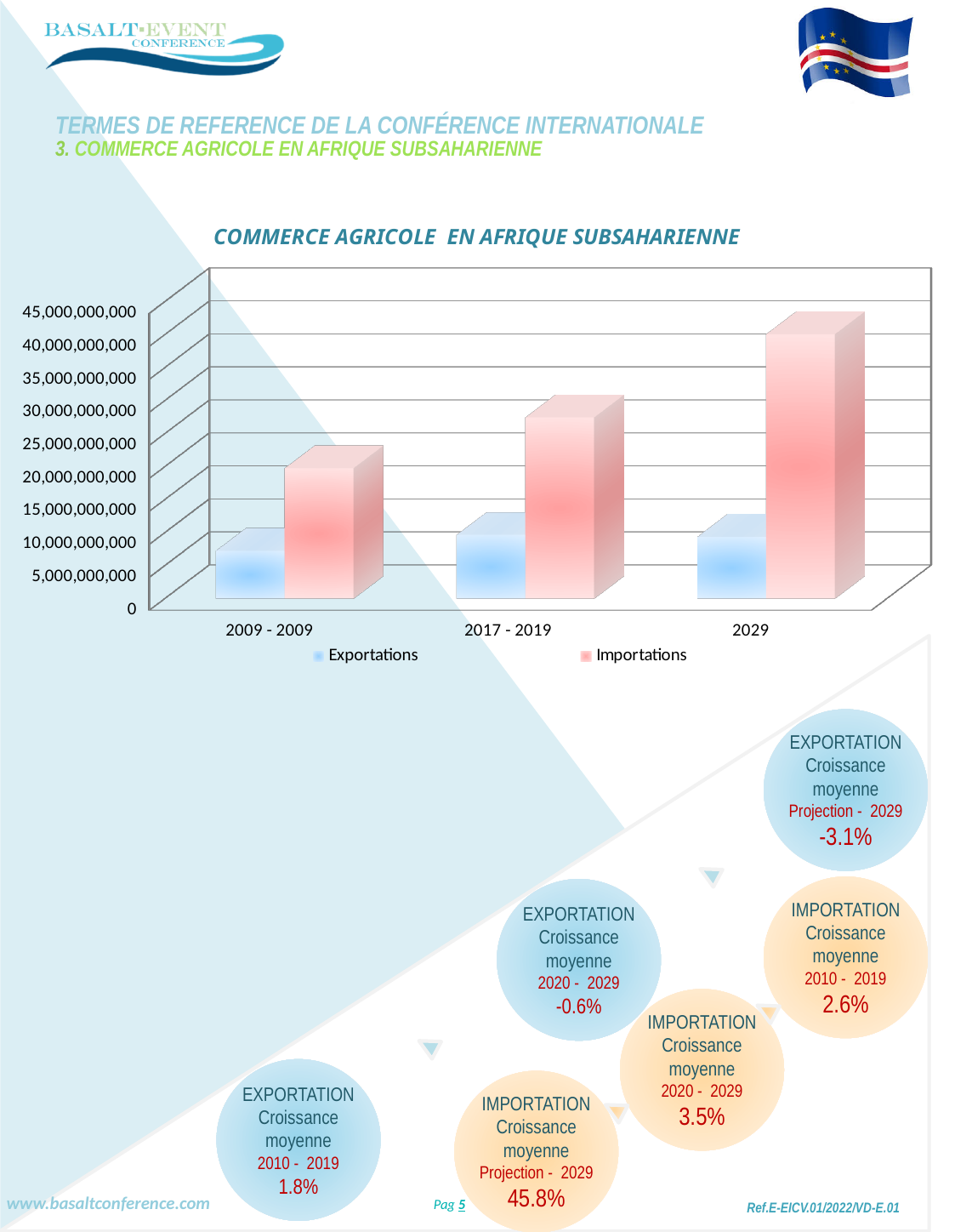
Is the Importations value for 2029 greater or less than 35,000,000,000? greater What is the title of the chart? COMMERCE AGRICOLE EN AFRIQUE SUBSAHARIENNE In which category is the Exportations bar the lowest? 2009 - 2009 Is the Exportations value for 2009 - 2009 greater or less than 10,000,000,000? less What kind of chart is shown on the slide? bar chart Which series is shown in blue in the chart? Exportations In which category is the Importations bar the highest? 2029 For 2029, which is larger, Exportations or Importations? Importations Do the Importations values rise or fall across the categories from left to right? rise How many series does the chart legend list? 2 How many categories are shown on the x axis of the chart? 3 Is the Importations value for 2017 - 2019 greater or less than 20,000,000,000? greater